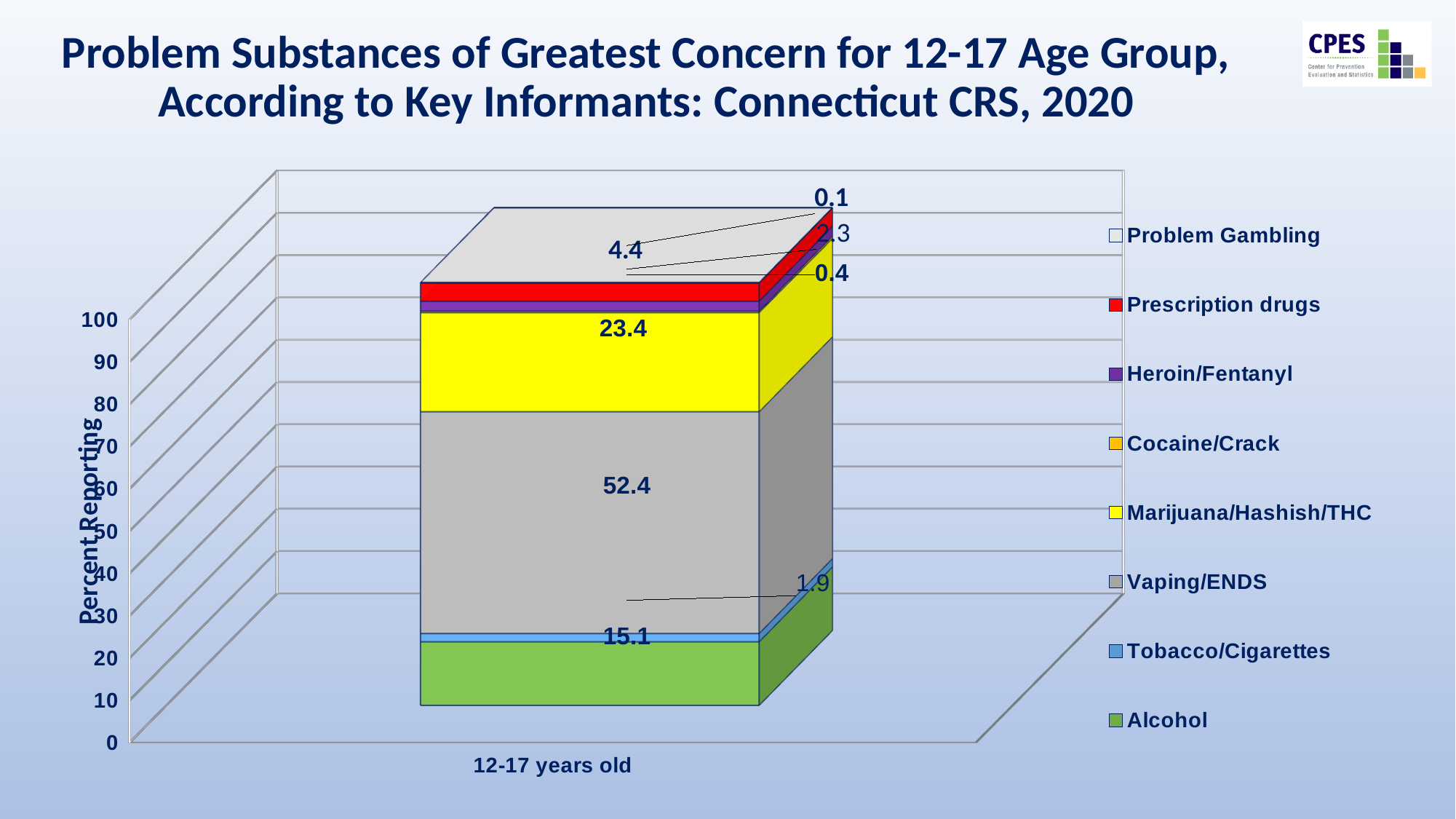
Which substance has the smallest segment in the stacked bar? Problem Gambling What percentage of key informants reported Vaping/ENDS as a problem substance of greatest concern for the 12-17 age group? 52.4 What is the label on the vertical axis? Percent Reporting Which is larger, the value for Alcohol or the value for Tobacco/Cigarettes? Alcohol What value is shown for Prescription drugs? 4.4 What value is shown for Marijuana/Hashish/THC? 23.4 What kind of chart is shown on the slide? Stacked bar chart What value is shown for Heroin/Fentanyl? 2.3 What is the difference between the Vaping/ENDS value and the Marijuana/Hashish/THC value? 29.0 What value is shown for Alcohol in the stacked bar? 15.1 How many series does the legend list? 8 Which substance has the largest segment in the stacked bar? Vaping/ENDS